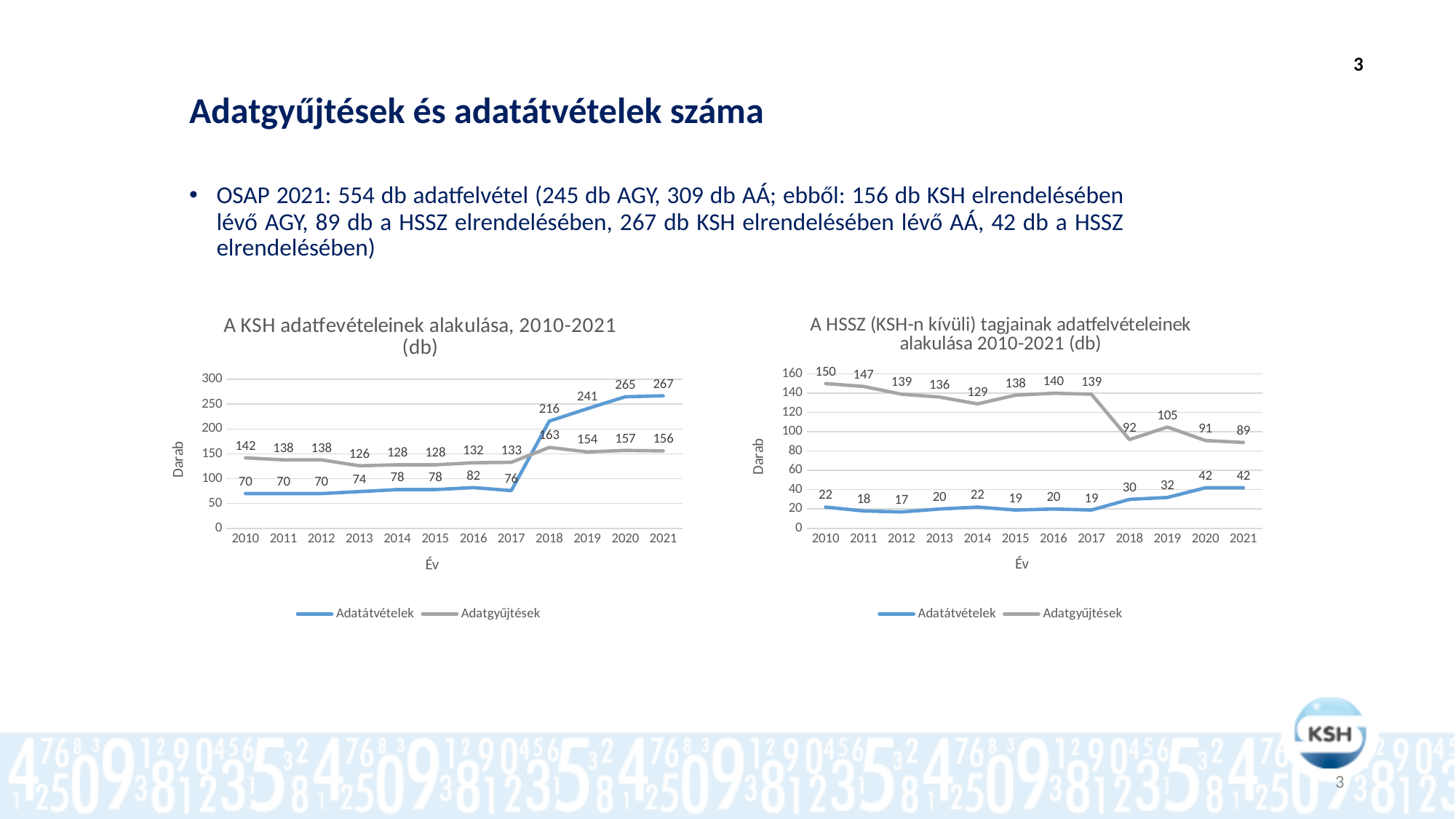
What type of chart is the left chart (A KSH adatfevételeinek alakulása)? line chart How many series does the legend of the right chart (A HSSZ tagjainak adatfelvételeinek alakulása) list? 2 In the right chart (A HSSZ tagjainak adatfelvételeinek alakulása), what is the value of Adatgyűjtések in 2014? 129 How many years are shown on the x axis of the left chart (A KSH adatfevételeinek alakulása)? 12 In the right chart (A HSSZ tagjainak adatfelvételeinek alakulása), what is the difference between Adatgyűjtések in 2010 and in 2021? 61 In the right chart (A HSSZ tagjainak adatfelvételeinek alakulása), does Adatgyűjtések generally rise or fall from 2010 to 2021? fall In the left chart (A KSH adatfevételeinek alakulása), which series has the larger value in 2019, Adatátvételek or Adatgyűjtések? Adatátvételek In the right chart (A HSSZ tagjainak adatfelvételeinek alakulása), in which year is Adatátvételek lowest? 2012 In the left chart (A KSH adatfevételeinek alakulása), what is the difference between Adatátvételek in 2018 and in 2017? 140 In the left chart (A KSH adatfevételeinek alakulása), in which year is Adatgyűjtések highest? 2018 In the left chart (A KSH adatfevételeinek alakulása), what is the value of Adatgyűjtések in 2010? 142 In the left chart (A KSH adatfevételeinek alakulása), what is the value of Adatátvételek in 2021? 267